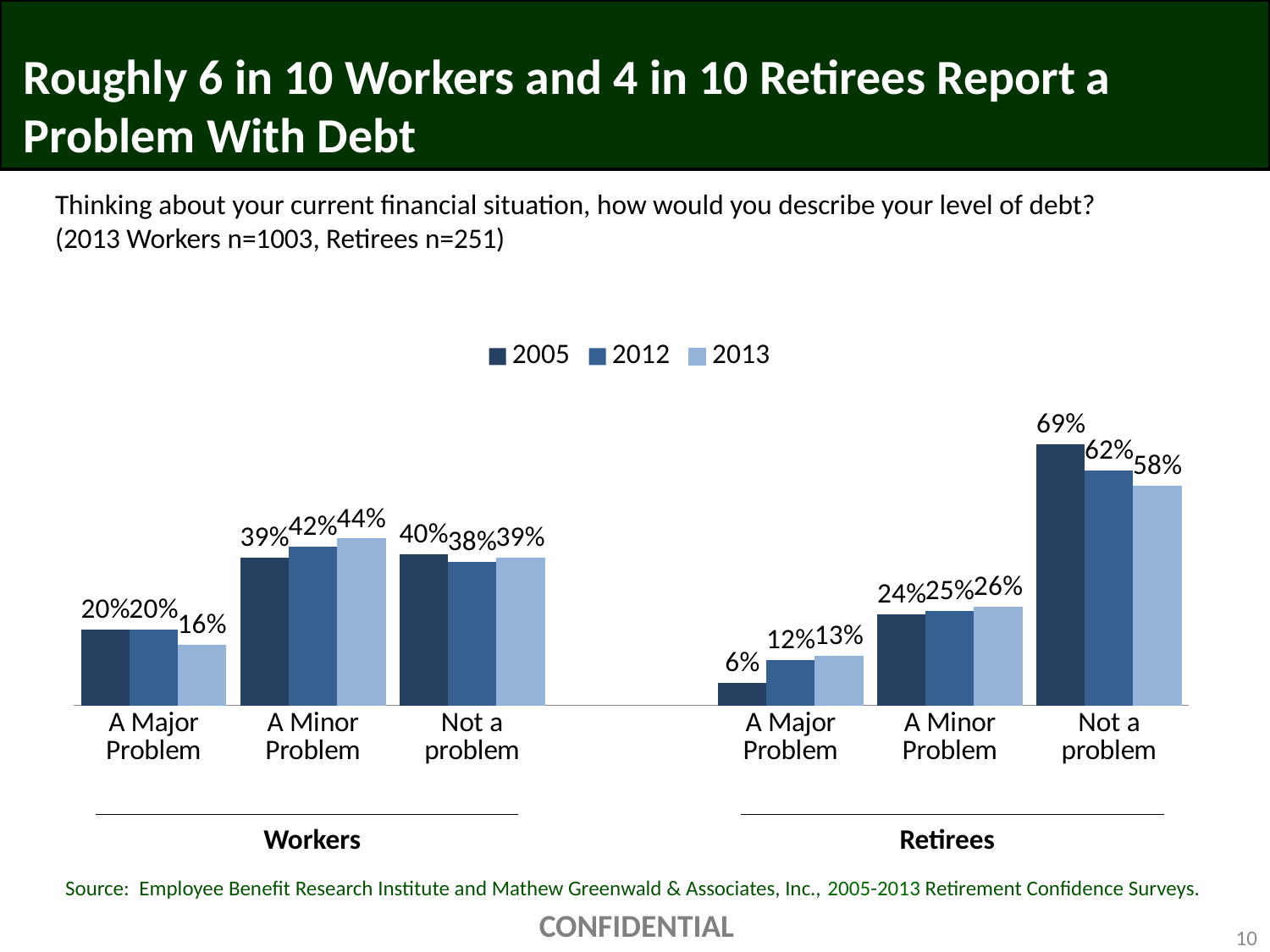
What is the difference between Workers and Retirees reporting 'A Major Problem' in 2013? 3% Which years are listed in the chart legend? 2005, 2012, 2013 For Workers in 2013, which is larger: 'A Minor Problem' or 'Not a problem'? A Minor Problem Among Retirees, which response category has the lowest value in 2005? A Major Problem What percentage of Workers reported debt as 'A Major Problem' in 2013? 16% How did the share of Retirees saying debt is 'Not a problem' change from 2005 to 2013? It fell What percentage of Retirees said debt was 'Not a problem' in 2005? 69% What percentage of Retirees reported debt as 'A Major Problem' in 2012? 12% How many series does the legend list? 3 What type of chart is shown on the slide? Bar chart Among Retirees, which response category has the highest value in 2013? Not a problem What is the difference between the 2005 and 2013 values for Retirees saying debt is 'Not a problem'? 11%